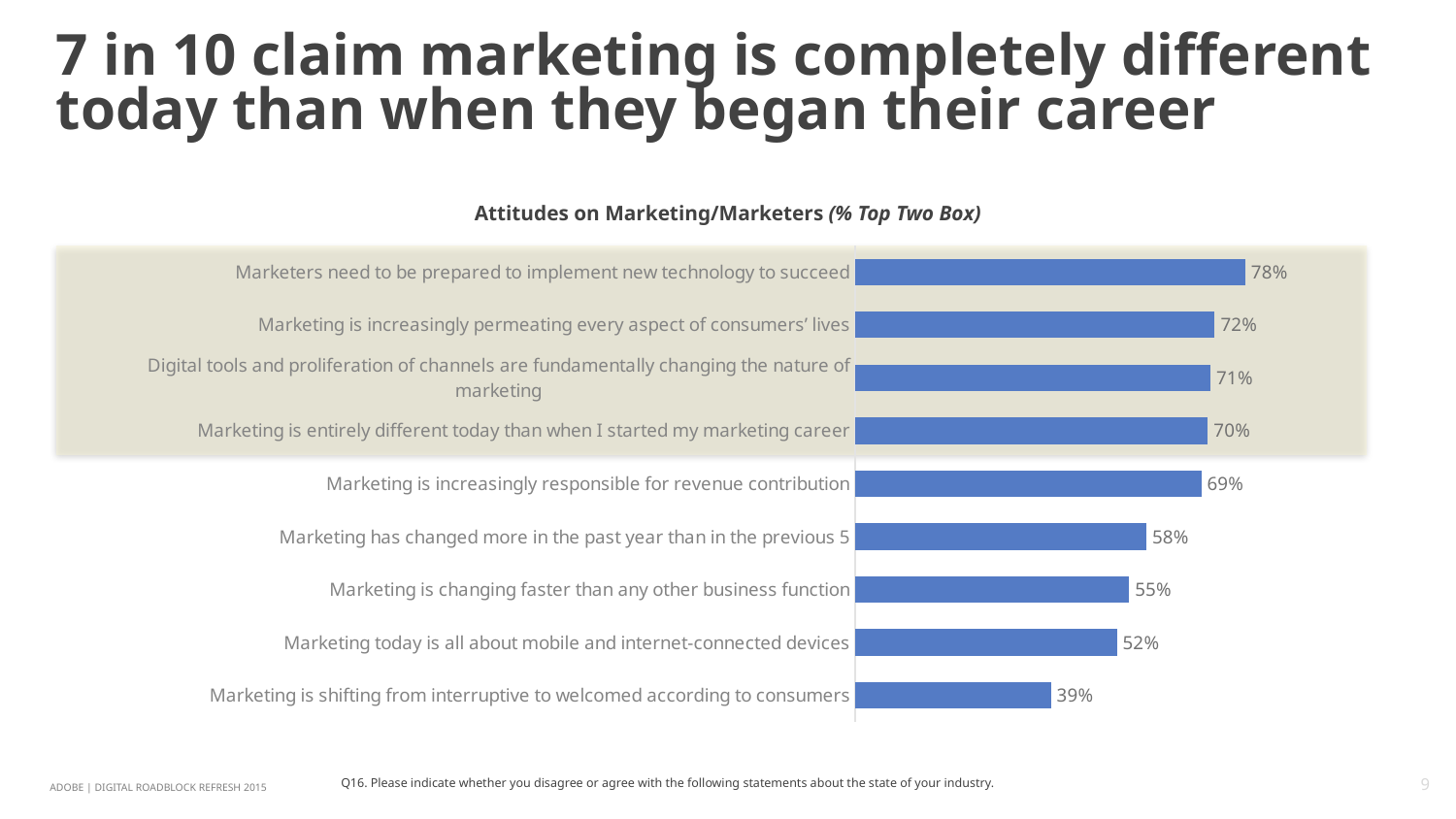
What percentage agree that marketers need to be prepared to implement new technology to succeed? 78% How many statements are shown in the chart? 9 What type of chart is shown on the slide? Bar chart What is the value for 'Marketing has changed more in the past year than in the previous 5'? 58% What is the title of the chart? Attitudes on Marketing/Marketers (% Top Two Box) What percentage agree that marketing is shifting from interruptive to welcomed according to consumers? 39% What is the difference between the highest and lowest values in the chart? 39% What is the difference between 'Marketing is increasingly permeating every aspect of consumers' lives' and 'Marketing is changing faster than any other business function'? 17% Which is larger: the value for 'Marketing is increasingly responsible for revenue contribution' or 'Marketing today is all about mobile and internet-connected devices'? Marketing is increasingly responsible for revenue contribution Which statement has the highest percentage? Marketers need to be prepared to implement new technology to succeed What is the value for 'Marketing is entirely different today than when I started my marketing career'? 70% Which statement has the lowest percentage? Marketing is shifting from interruptive to welcomed according to consumers